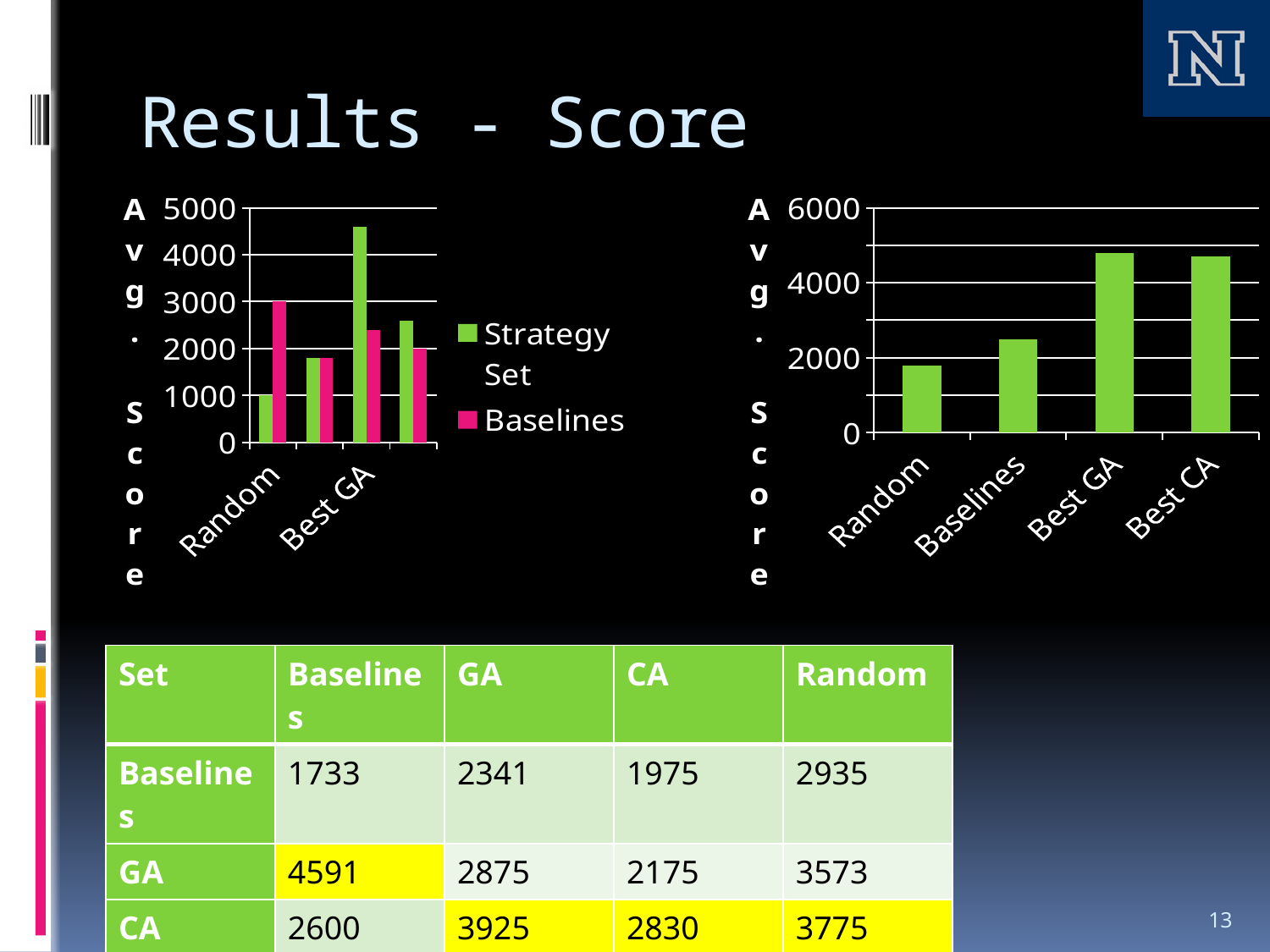
On the right chart, is the value for Best GA greater or less than 4000? greater On the left chart, is the Strategy Set value for Random greater or less than 2000? less On the right chart, which category has the lowest value? Random On the left chart, for Best GA, which is larger: Strategy Set or Baselines? Strategy Set What are the two legend entries on the left chart? Strategy Set and Baselines On the left chart, is the Strategy Set value for Best GA greater or less than 4000? greater How many series does the legend of the left chart list? 2 On the right chart, which is larger: Baselines or Random? Baselines What kind of chart is the left chart? bar chart On the left chart, for Random, which is larger: Strategy Set or Baselines? Baselines How many categories are shown on the right chart? 4